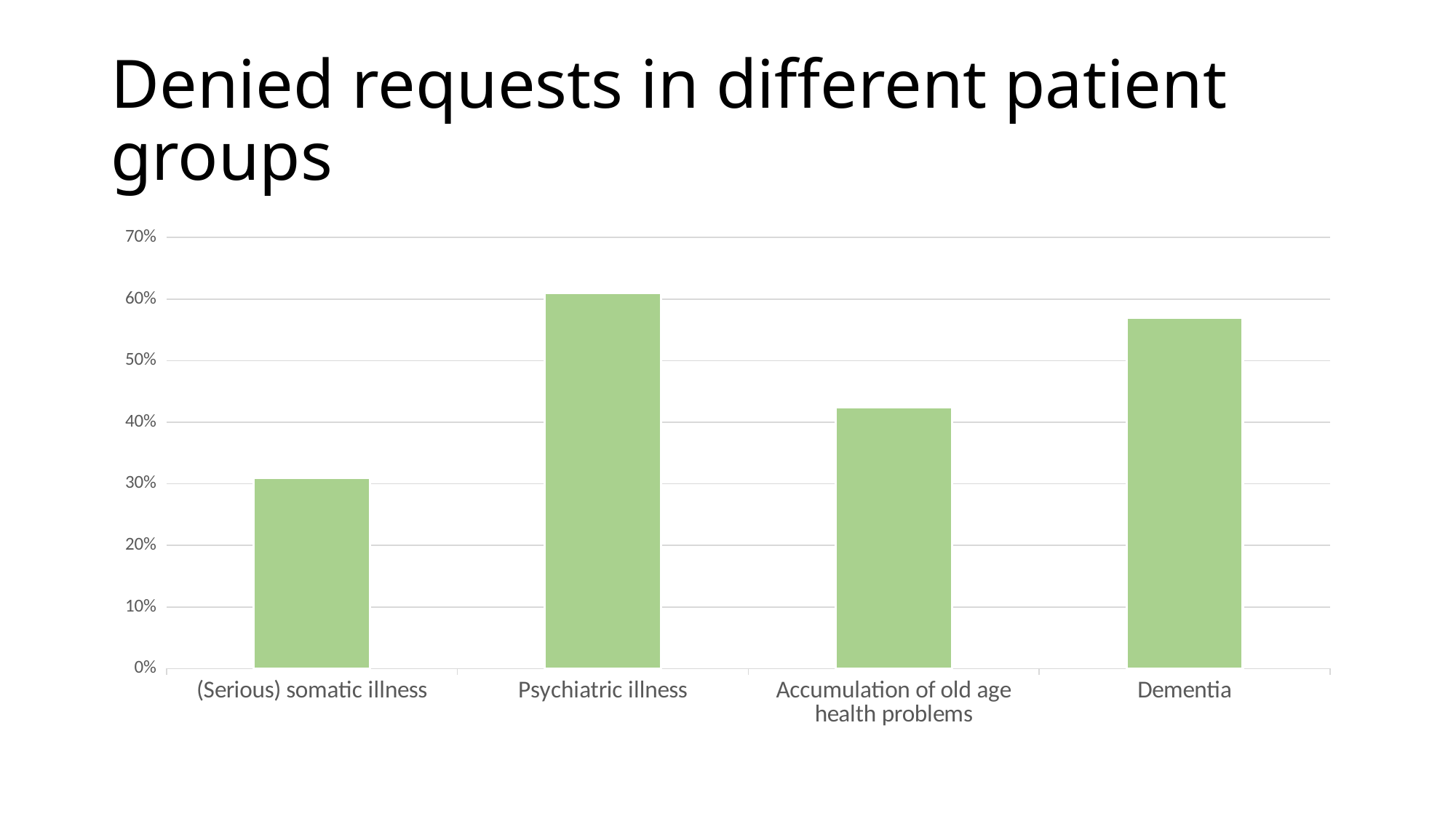
Which is larger, the value for Psychiatric illness or the value for (Serious) somatic illness? Psychiatric illness Which patient group has the highest share of denied requests? Psychiatric illness Is the value for Accumulation of old age health problems greater or less than 50%? less Which is larger, the value for Dementia or the value for Accumulation of old age health problems? Dementia Is the value for Dementia greater or less than 50%? greater Which patient group has the lowest share of denied requests? (Serious) somatic illness How many patient groups are shown on the x axis? 4 Is the value for (Serious) somatic illness greater or less than 40%? less What is the title of the slide? Denied requests in different patient groups What kind of chart is shown on the slide? bar chart What is the highest value shown on the y axis? 70%